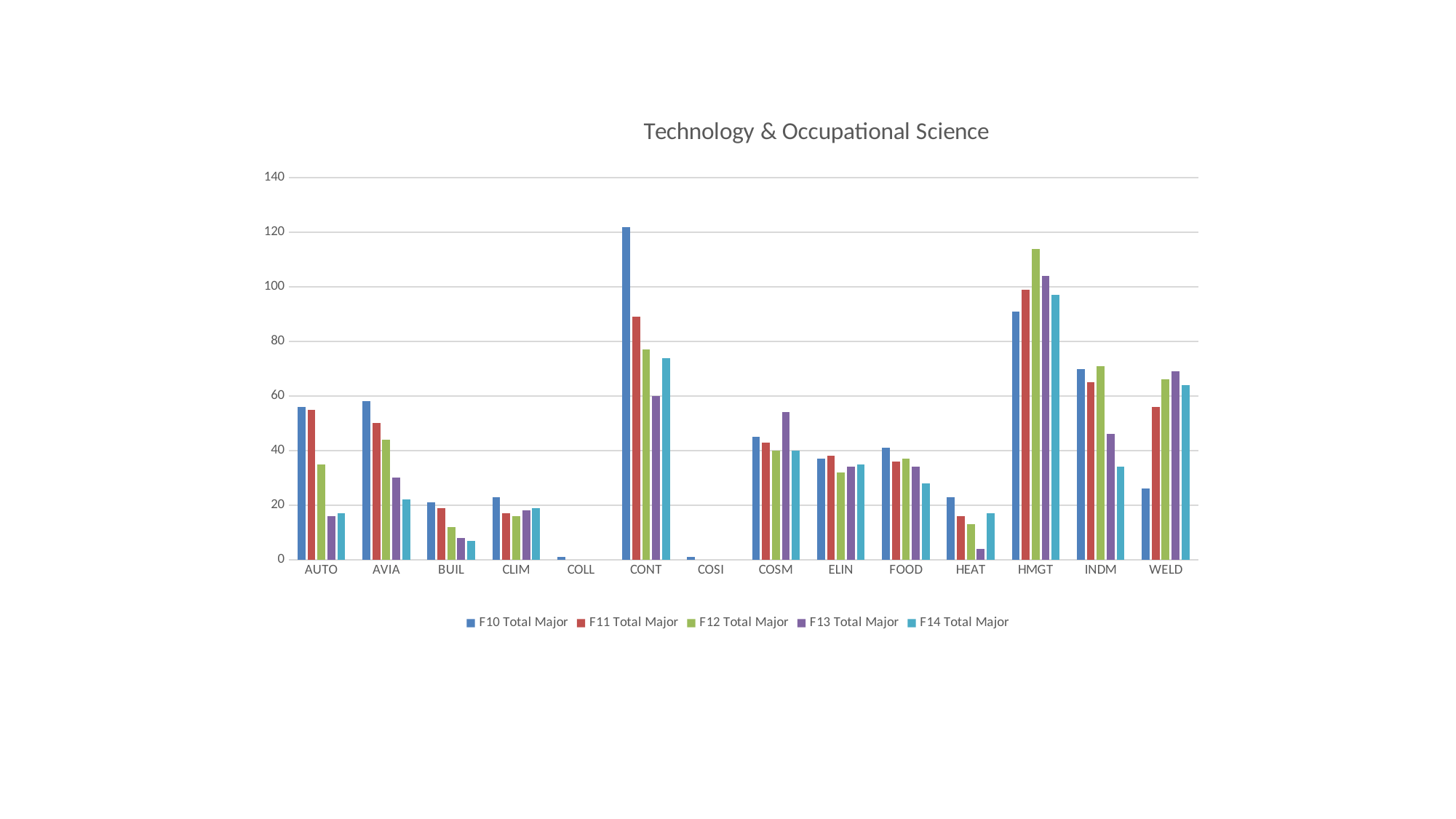
How many categories are shown on the x axis? 14 Is the F10 Total Major value for CONT greater or less than 100? greater What is the title of the chart? Technology & Occupational Science Which is larger for INDM: the F12 Total Major value or the F14 Total Major value? F12 Total Major How many series does the legend list? 5 Which category has the highest F12 Total Major value? HMGT For BUIL, do the values rise or fall from F10 Total Major through F14 Total Major? fall Is the F10 Total Major value for WELD greater or less than 40? less Which is larger for COSM: the F10 Total Major value or the F13 Total Major value? F13 Total Major What kind of chart is shown on the slide? Bar chart Which category has the highest F10 Total Major value? CONT Is the F13 Total Major value for HEAT greater or less than 20? less